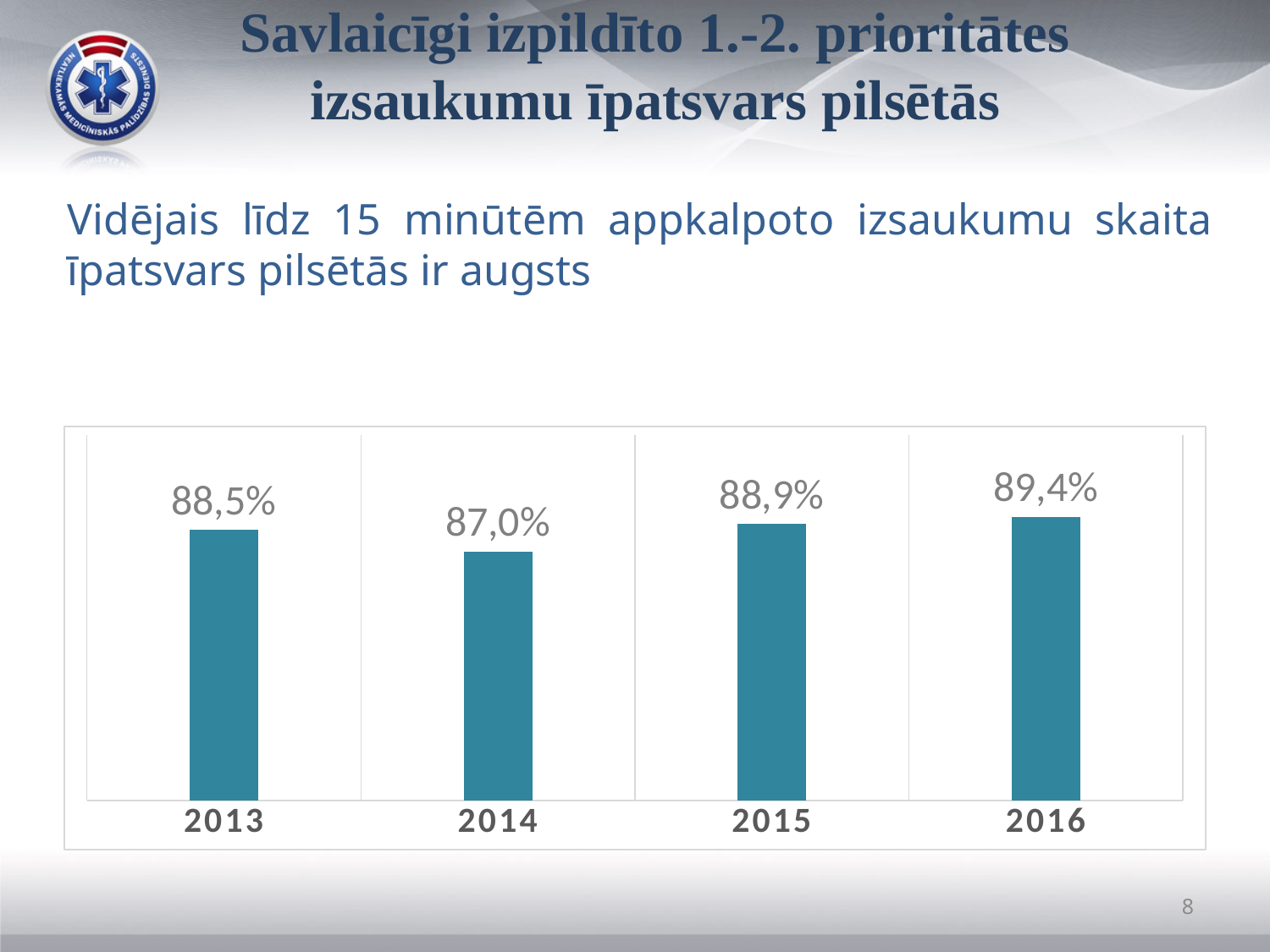
Which year has the highest value? 2016 What is the value for 2014? 87,0% What is the value for 2015? 88,9% What is the difference between the values for 2016 and 2014? 2,4% What kind of chart is shown on the slide? bar chart What is the value for 2013? 88,5% What is the difference between the values for 2015 and 2013? 0,4% What is the value for 2016? 89,4% How many years are shown on the chart? 4 Do the values rise or fall from 2014 to 2016? rise Which is larger, the value for 2013 or the value for 2014? 2013 Which year has the lowest value? 2014